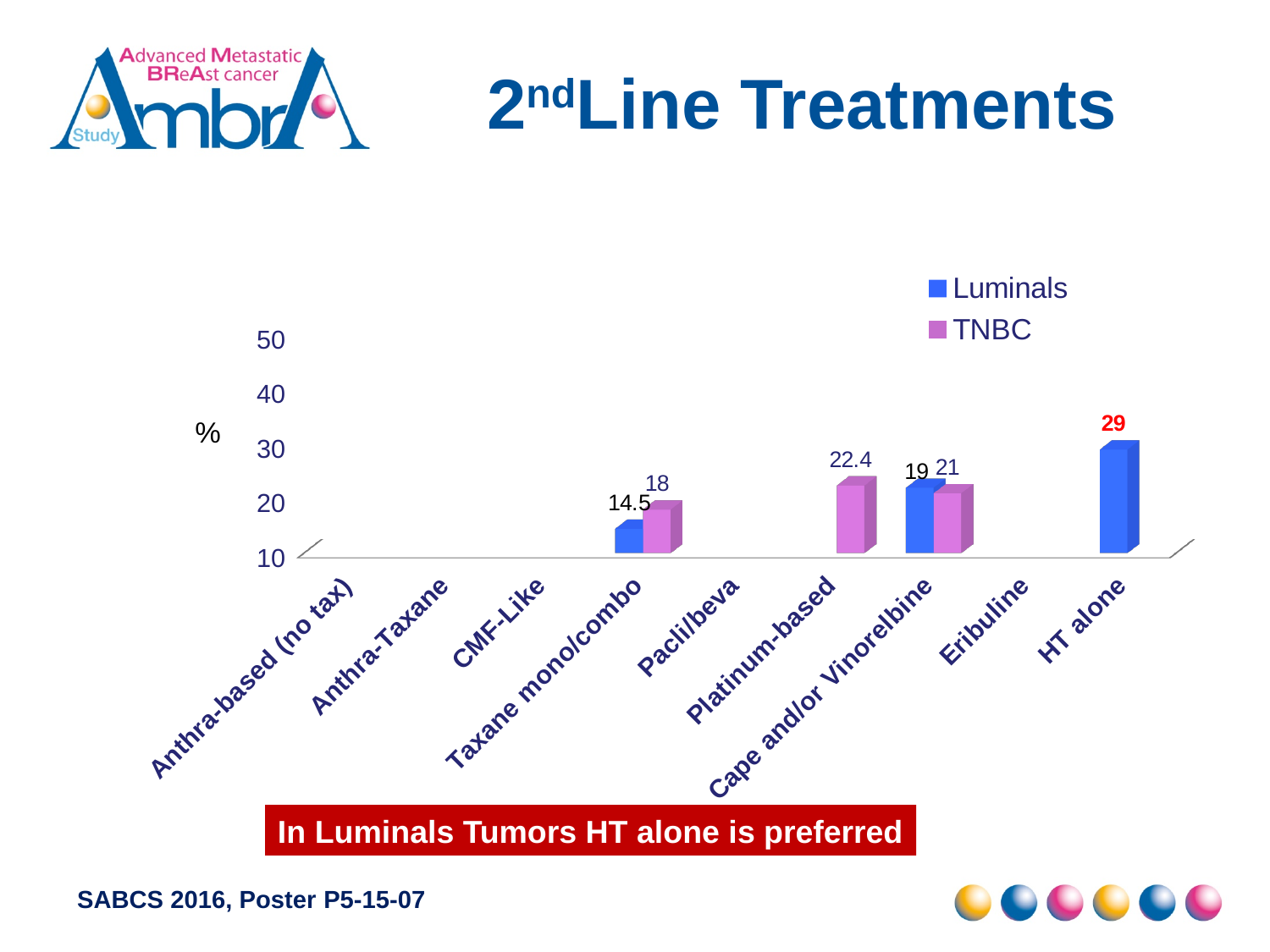
What is the Luminals value for HT alone? 29 For Taxane mono/combo, which series has the larger value, Luminals or TNBC? TNBC Which treatment has the highest Luminals value? HT alone Which treatment has the highest TNBC value? Platinum-based How many treatment categories are shown on the x axis? 9 What is the TNBC value for Taxane mono/combo? 18 What is the difference between the TNBC and Luminals values for Cape and/or Vinorelbine? 2 What kind of chart is shown on the slide? bar chart What is the TNBC value for Platinum-based? 22.4 How many series does the legend list? 2 What is the title of the slide containing the chart? 2nd Line Treatments What is the Luminals value for Taxane mono/combo? 14.5